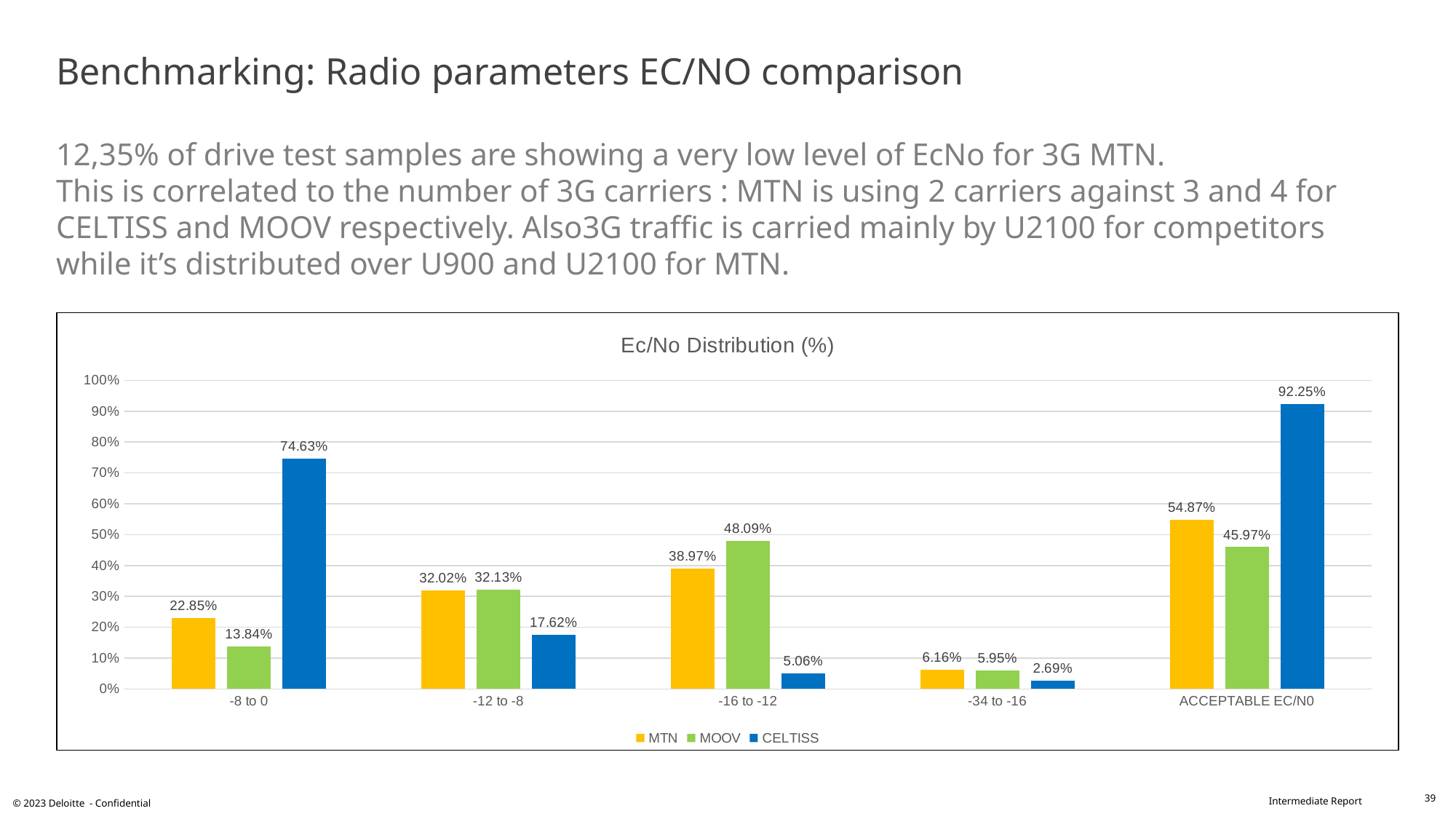
Which is larger in the -16 to -12 category: MTN or MOOV? MOOV What kind of chart is shown? Bar chart What is the difference between the MTN and MOOV values in the -8 to 0 category? 9.01% Which series has the highest value in the ACCEPTABLE EC/N0 category? CELTISS Which series has the lowest value in the -34 to -16 category? CELTISS What is the title of the chart? Ec/No Distribution (%) Is the CELTISS value for ACCEPTABLE EC/N0 greater or less than 90%? greater How many series does the legend list? 3 What is the MTN value for ACCEPTABLE EC/N0? 54.87% What is the CELTISS value for the -8 to 0 category? 74.63% How many categories are shown on the x axis? 5 What is the MOOV value for the -16 to -12 category? 48.09%